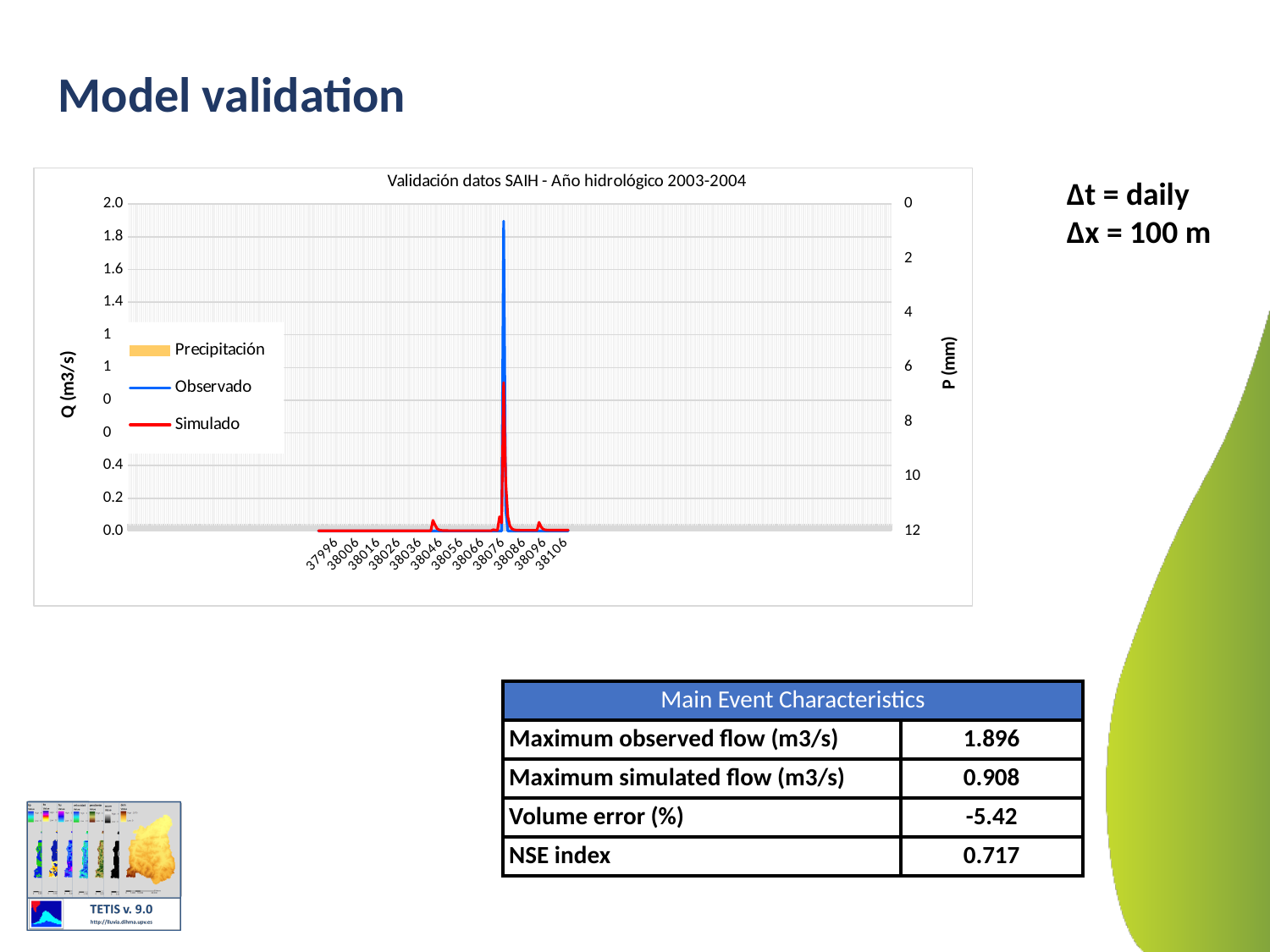
What is the largest tick value shown on the right vertical axis (P)? 12 What are the three entries in the chart legend? Precipitación, Observado, Simulado Is the peak value of the Simulado series greater or less than 1.4? less How many tick labels are shown along the x axis of the chart? 12 Is the peak value of the Observado series greater or less than 1.8? greater Is the peak value of the Simulado series greater or less than 0.4? greater What kind of chart is shown on the slide? combination bar and line chart Which series reaches a higher peak, Observado or Simulado? Observado What is the highest tick value shown on the left vertical axis (Q)? 2.0 What is the title of the chart? Validación datos SAIH - Año hidrológico 2003-2004 How many series does the chart legend list? 3 What is the first tick label shown on the x axis? 37996